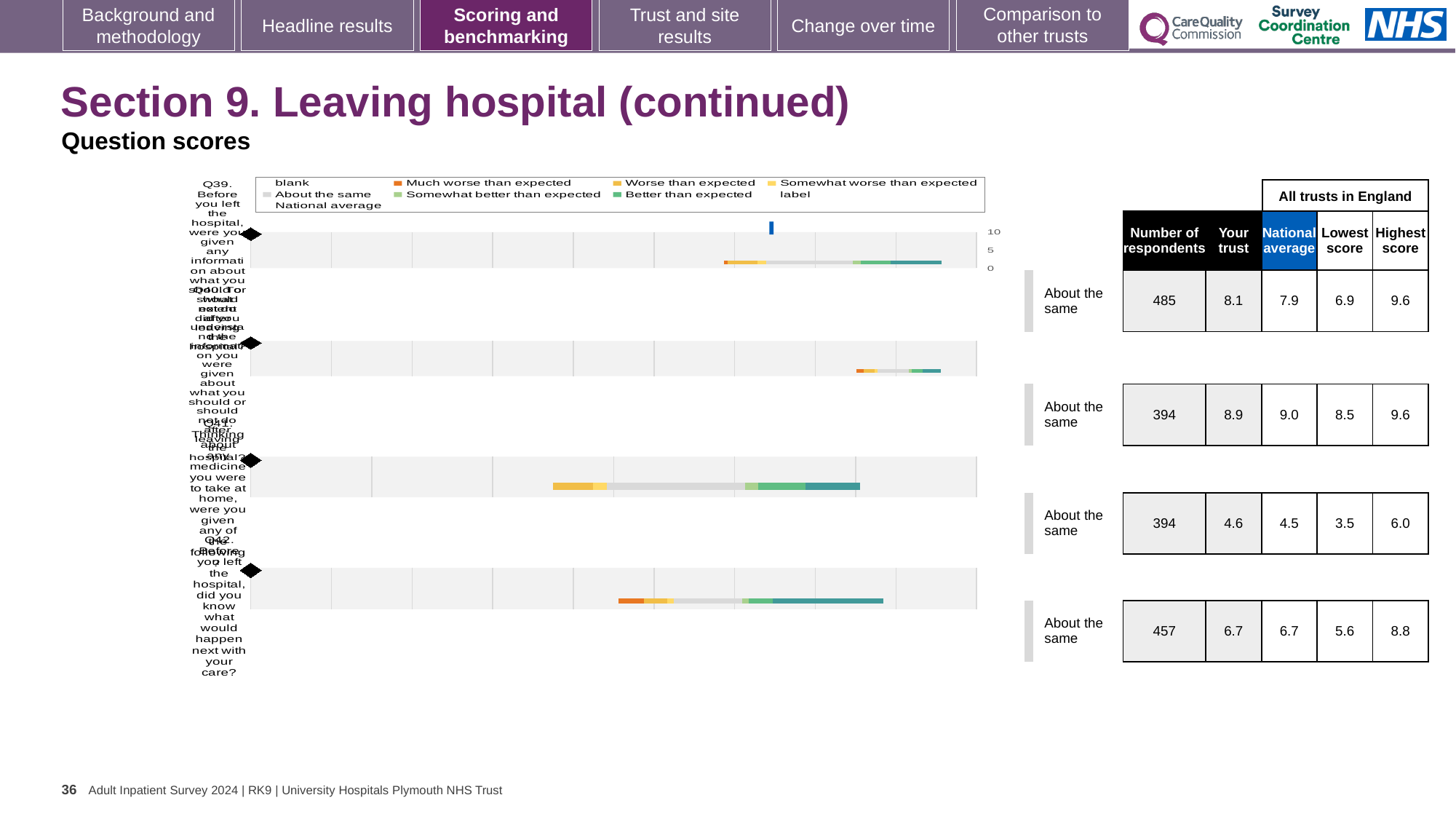
For the first chart from the top (Q39), what is the difference between the highest score (9.6) and the lowest score (6.9)? 2.7 What kind of chart is used for the question scores on this slide? bar chart What benchmark category is shown next to every chart row? About the same Which chart row has the lowest 'Your trust' score? the third row (4.6) How many question charts (rows) are shown on the slide? 4 Which chart row has the highest 'Your trust' score? the second row (8.9) For the first chart from the top (Q39), how many respondents are listed? 485 In the legend, what colour represents 'Much worse than expected'? orange For the third chart from the top, what is the national average score? 4.5 For the second chart from the top, which is larger: the 'Your trust' score or the national average? national average For the fourth chart from the top (Q42), what is the highest score among all trusts in England? 8.8 For the first chart from the top (Q39), what is the 'Your trust' score shown in the table? 8.1